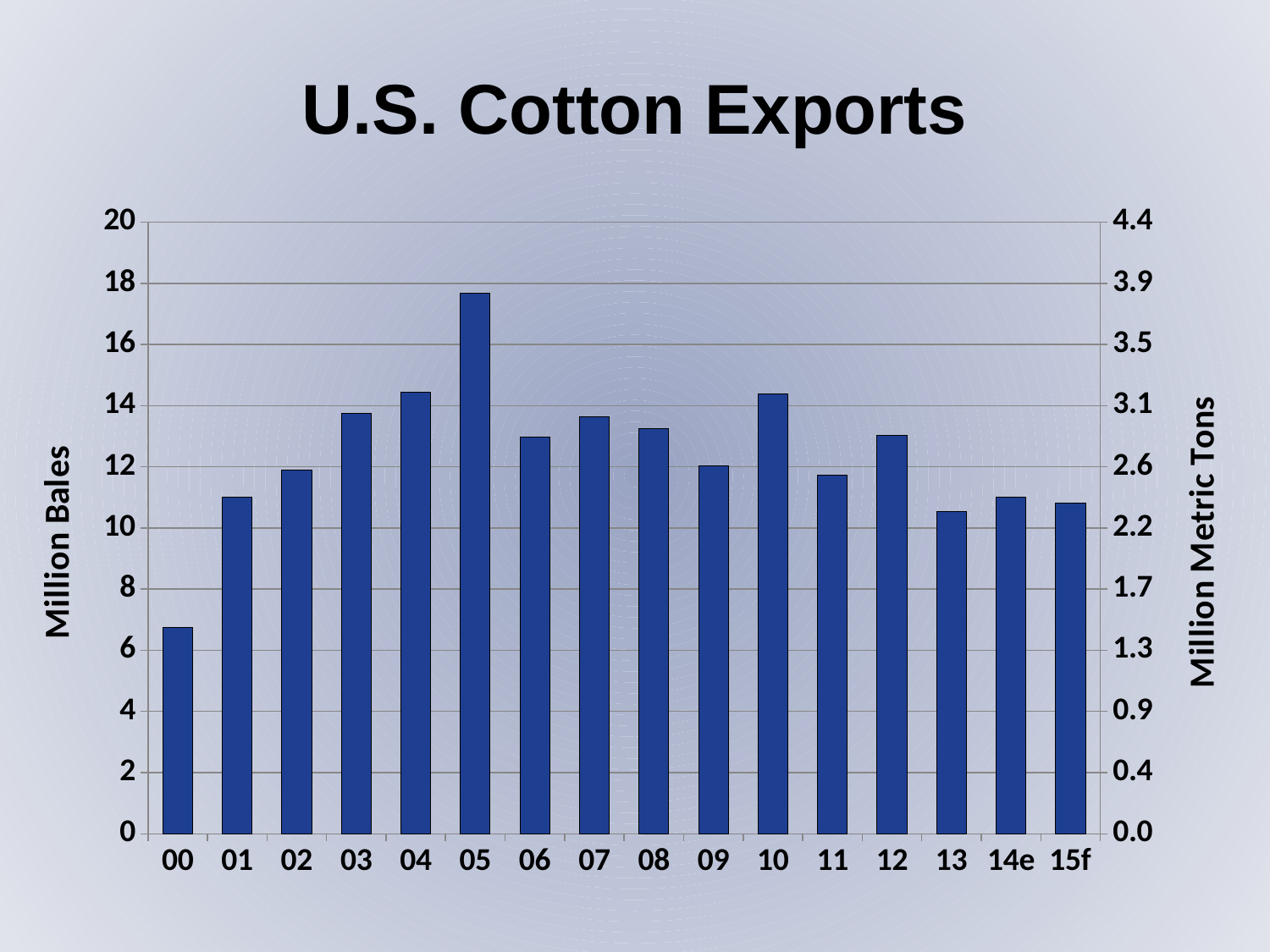
What is the label of the right-hand vertical axis? Million Metric Tons How many years (categories) are shown on the x axis? 16 Do the values rise or fall from 00 to 05? rise Which is larger, the value for 03 or the value for 01? 03 Is the value for 06 greater or less than 14 million bales? less What kind of chart is shown on the slide? bar chart Is the value for 13 greater or less than 10 million bales? greater Is the value for 00 greater or less than 8 million bales? less Which year has the lowest cotton exports? 00 What is the title of the chart? U.S. Cotton Exports Which year has the highest cotton exports? 05